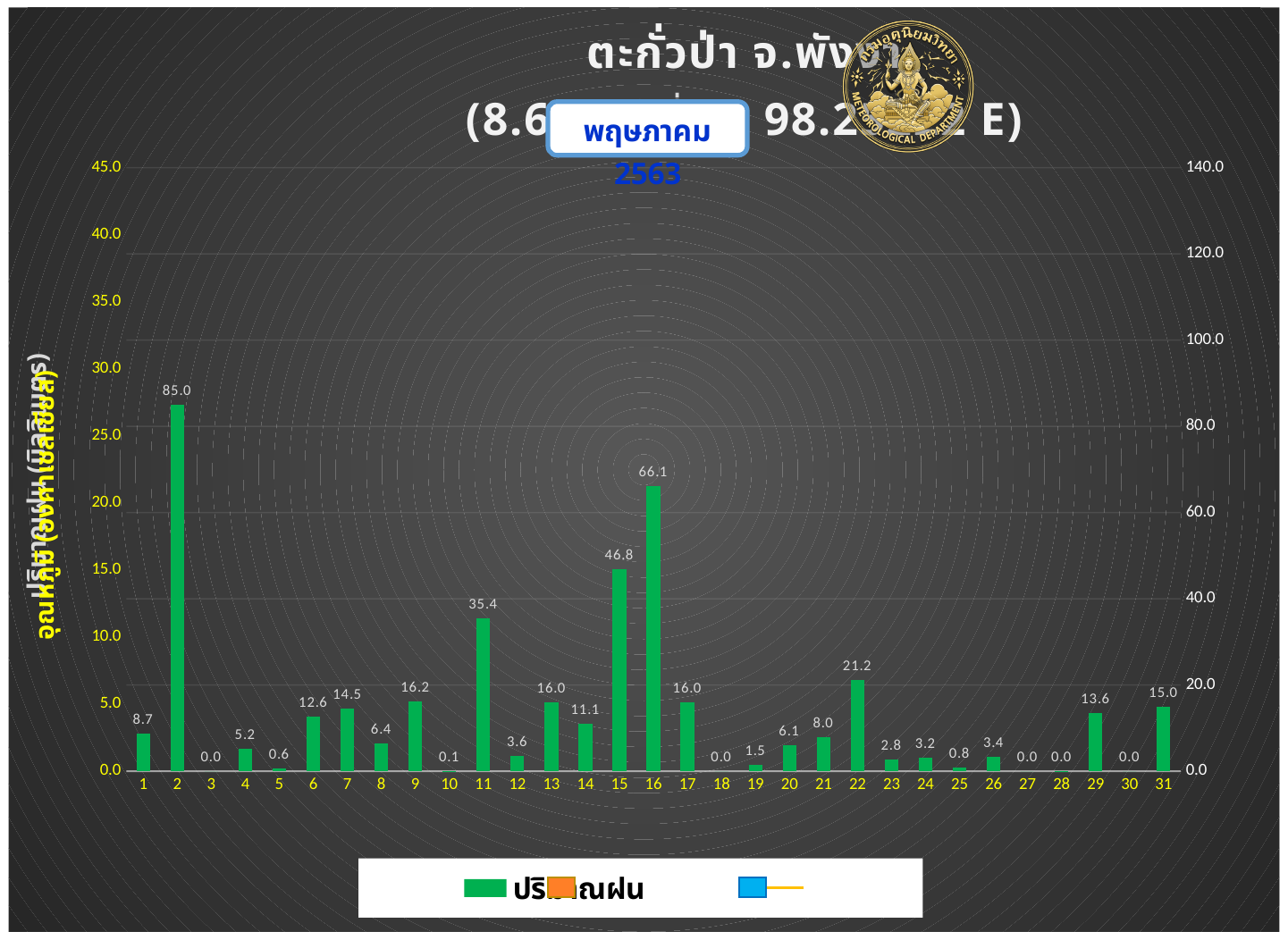
What is the difference between the values for day 15 and day 11? 11.4 What is the value shown for day 2? 85.0 How many days are shown on the x axis? 31 What is the value shown for day 22? 21.2 Is the value for day 2 greater or less than 80.0 on the right axis? greater What is the value shown for day 11? 35.4 Which day has the highest value? 2 What kind of chart is this? bar chart What is the value shown for day 16? 66.1 What is the difference between the values for day 2 and day 16? 18.9 How many days show a value of 0.0? 5 Which is larger, the value for day 9 or the value for day 7? day 9